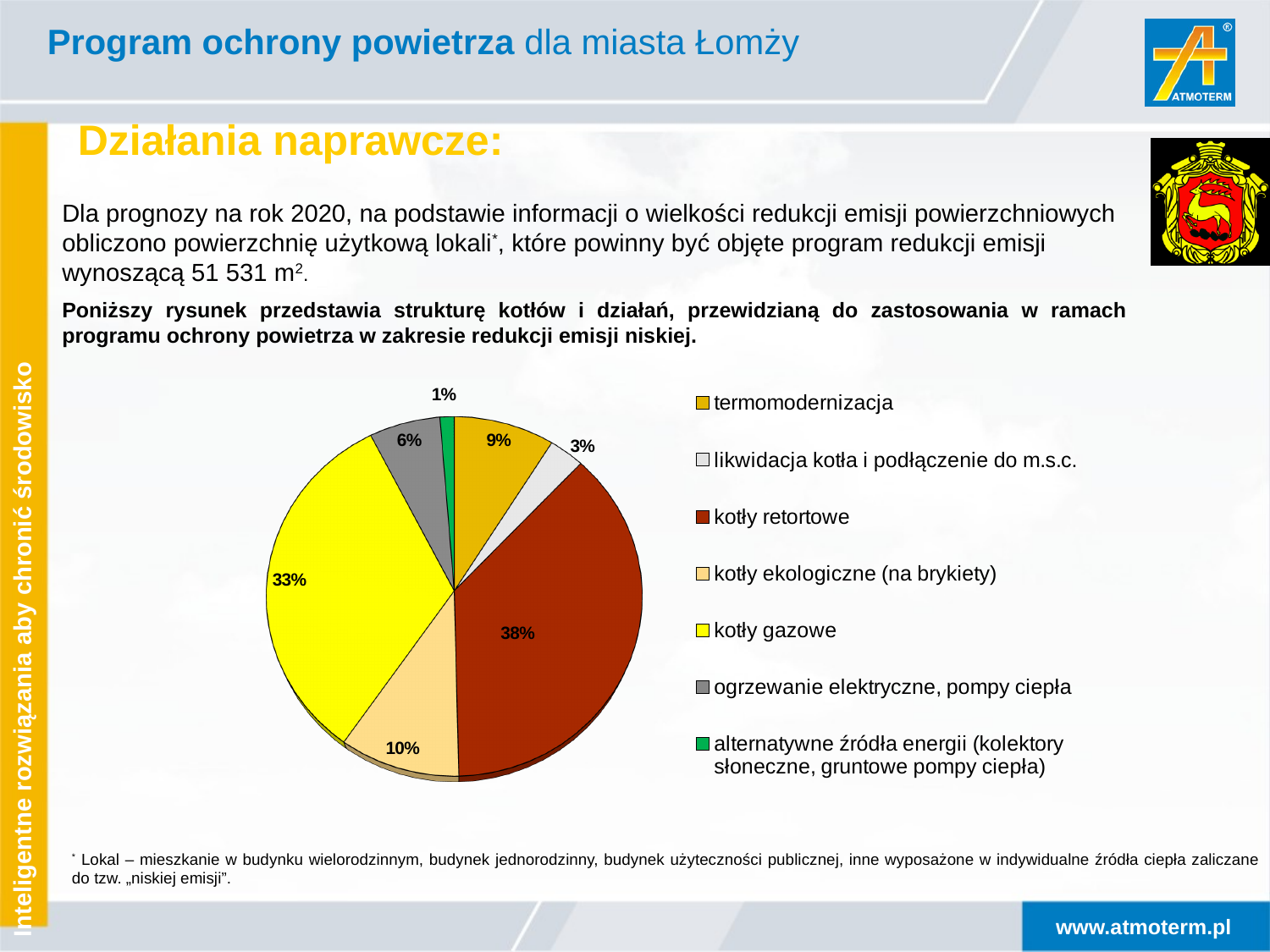
What is the difference in percentage points between "kotły retortowe" and "kotły gazowe"? 5 How many categories does the legend of the pie chart list? 7 What share of the pie does "kotły retortowe" have? 38% Which is larger: the share for "termomodernizacja" or the share for "ogrzewanie elektryczne, pompy ciepła"? termomodernizacja Which category has the smallest share of the pie? alternatywne źródła energii (kolektory słoneczne, gruntowe pompy ciepła) Which category has the largest share of the pie? kotły retortowe What share of the pie does "kotły ekologiczne (na brykiety)" have? 10% What share of the pie does "termomodernizacja" have? 9% What type of chart is shown on the slide? pie chart What colour is the slice for "kotły gazowe"? yellow